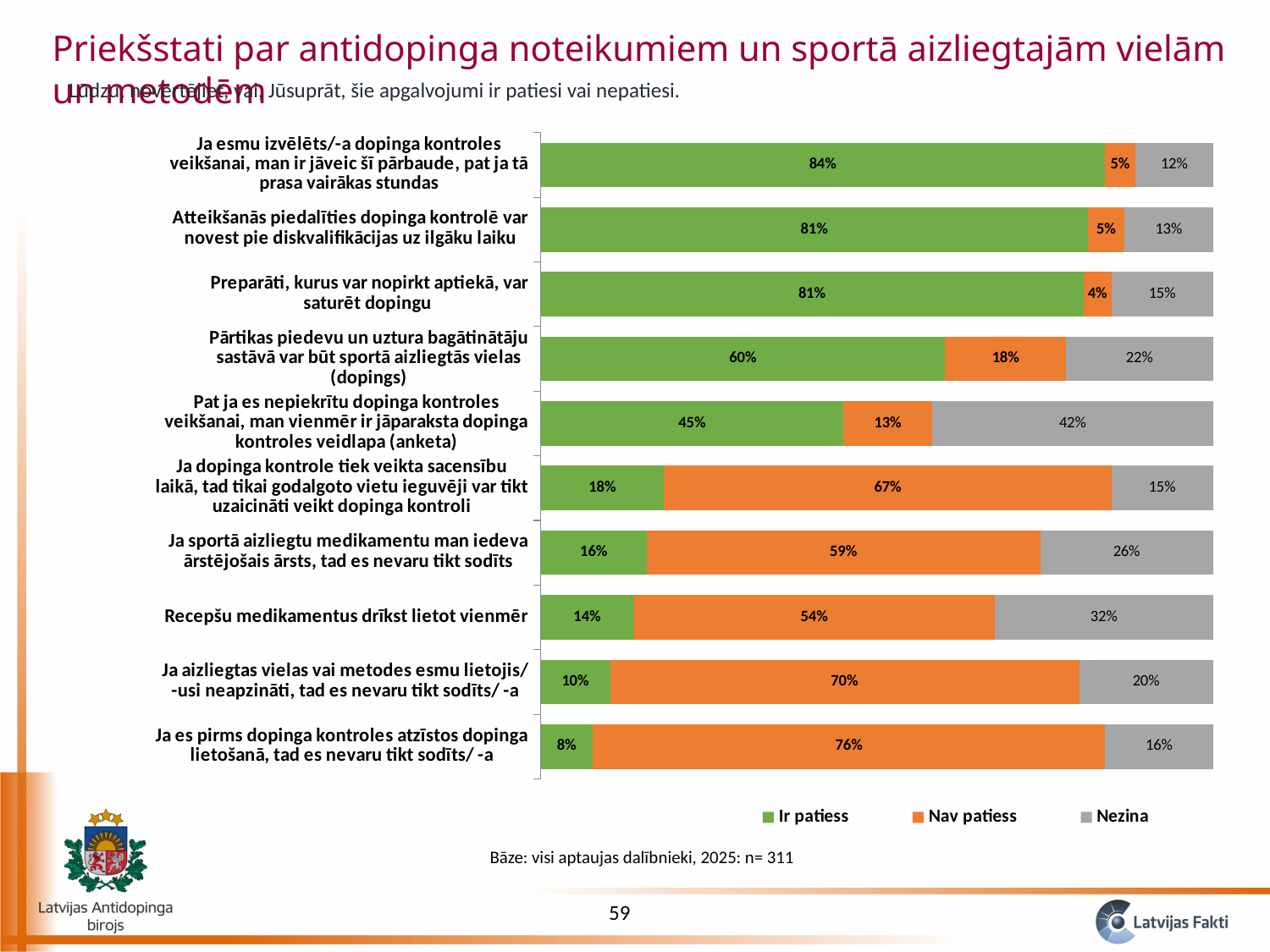
What is the 'Ir patiess' value for the statement 'Recepšu medikamentus drīkst lietot vienmēr'? 14% Which is larger: the 'Nezina' value for 'Recepšu medikamentus drīkst lietot vienmēr' or the 'Nezina' value for 'Ja sportā aizliegtu medikamentu man iedeva ārstējošais ārsts, tad es nevaru tikt sodīts'? Recepšu medikamentus drīkst lietot vienmēr Which colour represents the 'Nezina' series in the chart? Grey How many statements (categories) are plotted in the chart? 10 Which statement has the lowest 'Ir patiess' share? Ja es pirms dopinga kontroles atzīstos dopinga lietošanā, tad es nevaru tikt sodīts/-a Which statement has the highest 'Ir patiess' share? Ja esmu izvēlēts/-a dopinga kontroles veikšanai, man ir jāveic šī pārbaude, pat ja tā prasa vairākas stundas How many series does the legend list? 3 What kind of chart is shown on the slide? Stacked bar chart What is the 'Nav patiess' value for the statement 'Ja aizliegtas vielas vai metodes esmu lietojis/-usi neapzināti, tad es nevaru tikt sodīts/-a'? 70% Which statement has the highest 'Nav patiess' share? Ja es pirms dopinga kontroles atzīstos dopinga lietošanā, tad es nevaru tikt sodīts/-a What is the difference between the 'Ir patiess' value for 'Pārtikas piedevu un uztura bagātinātāju sastāvā var būt sportā aizliegtās vielas (dopings)' and the 'Ir patiess' value for 'Pat ja es nepiekrītu dopinga kontroles veikšanai, man vienmēr ir jāparaksta dopinga kontroles veidlapa (anketa)'? 15% What is the 'Nezina' value for the statement 'Pat ja es nepiekrītu dopinga kontroles veikšanai, man vienmēr ir jāparaksta dopinga kontroles veidlapa (anketa)'? 42%